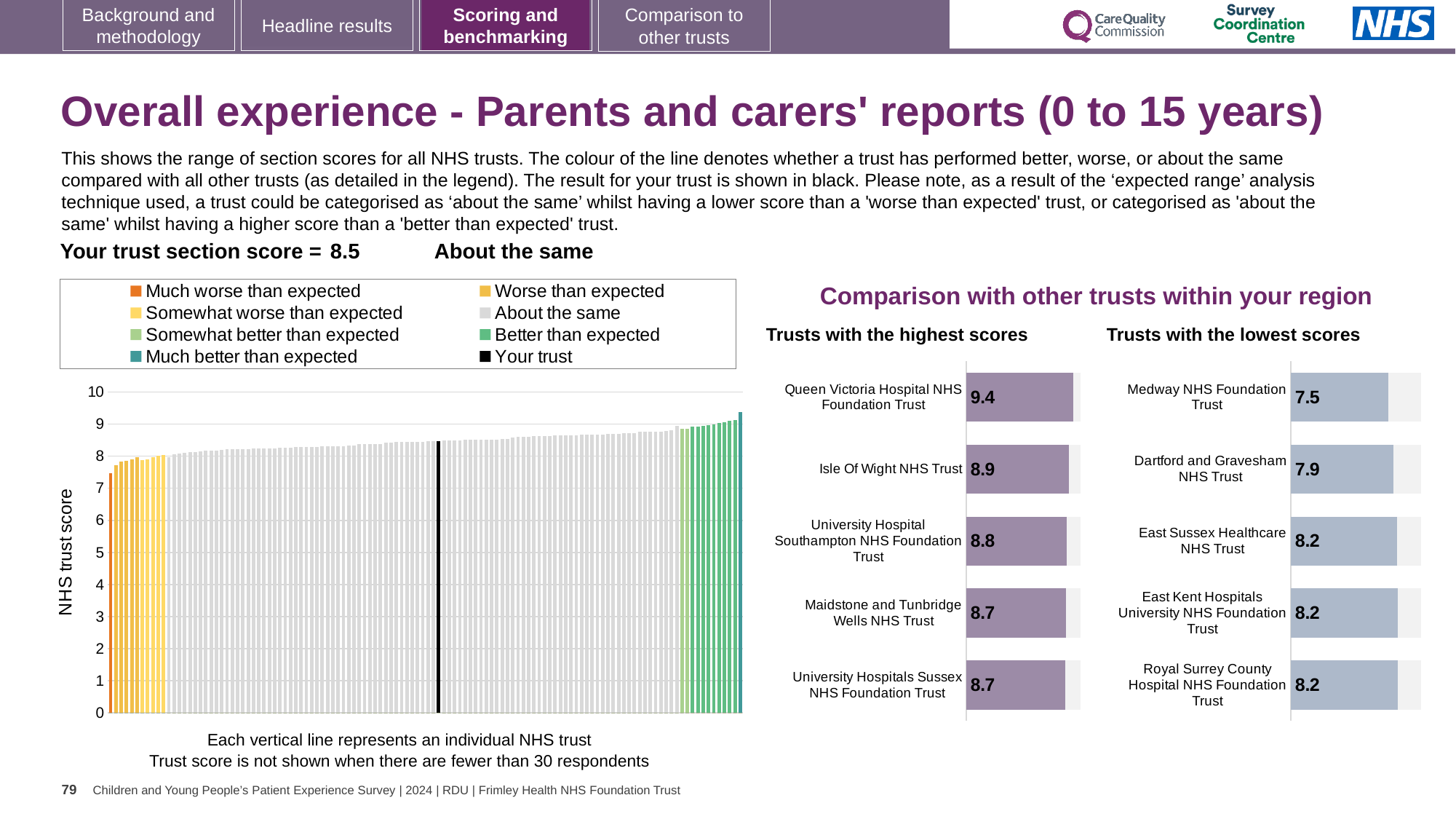
In the 'Trusts with the lowest scores' chart, what is the difference between the scores of Dartford and Gravesham NHS Trust and Medway NHS Foundation Trust? 0.4 In the 'Trusts with the highest scores' chart, which has the larger score: Isle Of Wight NHS Trust or University Hospital Southampton NHS Foundation Trust? Isle Of Wight NHS Trust In the 'Trusts with the highest scores' chart, which trust has the highest score? Queen Victoria Hospital NHS Foundation Trust In the 'Trusts with the lowest scores' chart, what is the score for Medway NHS Foundation Trust? 7.5 In the 'Trusts with the highest scores' chart, what score is shown for Maidstone and Tunbridge Wells NHS Trust? 8.7 How many trusts are listed in the 'Trusts with the lowest scores' chart? 5 In the large chart on the left, do the trust scores rise or fall from left to right along the x axis? Rise In the 'Trusts with the highest scores' chart, what is the score for Queen Victoria Hospital NHS Foundation Trust? 9.4 What kind of chart is the large chart on the left showing NHS trust scores? Bar chart In the 'Trusts with the lowest scores' chart, which trust has the lowest score? Medway NHS Foundation Trust In the 'Trusts with the highest scores' chart, what is the difference between the scores of Queen Victoria Hospital NHS Foundation Trust and Isle Of Wight NHS Trust? 0.5 How many entries does the legend above the large chart on the left list? 8